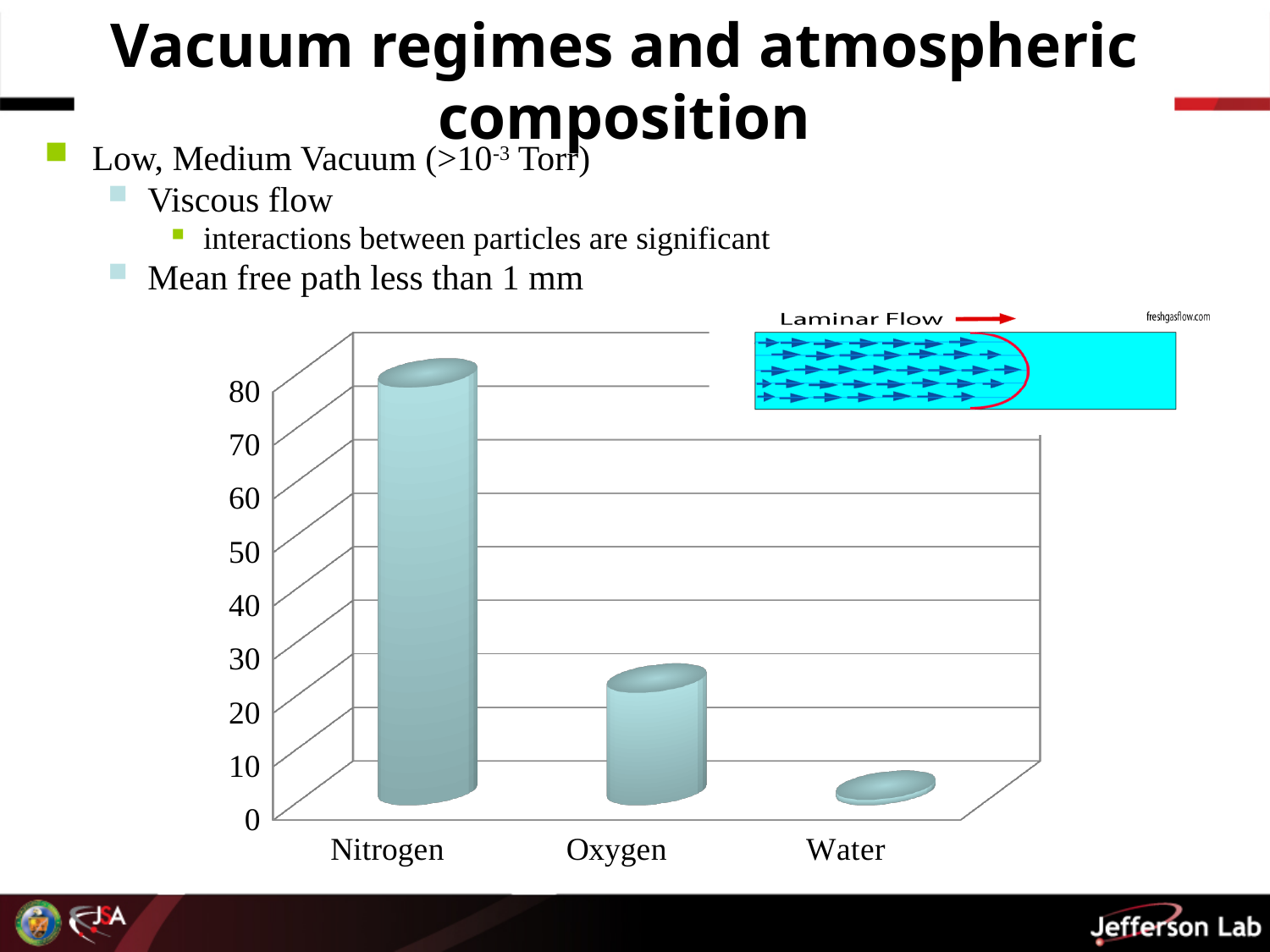
What is the highest tick value shown on the vertical axis of the chart? 80 Is the value for Nitrogen greater or less than 70? greater Do the values rise or fall moving from Nitrogen to Water along the x axis? fall What kind of chart is shown on the slide? bar chart Which is larger, the value for Nitrogen or the value for Oxygen? Nitrogen How many categories are plotted on the chart? 3 Is the value for Oxygen greater or less than 10? greater Is the value for Oxygen greater or less than 30? less Which category has the lowest value on the chart? Water Which category has the highest value on the chart? Nitrogen Which is larger, the value for Oxygen or the value for Water? Oxygen